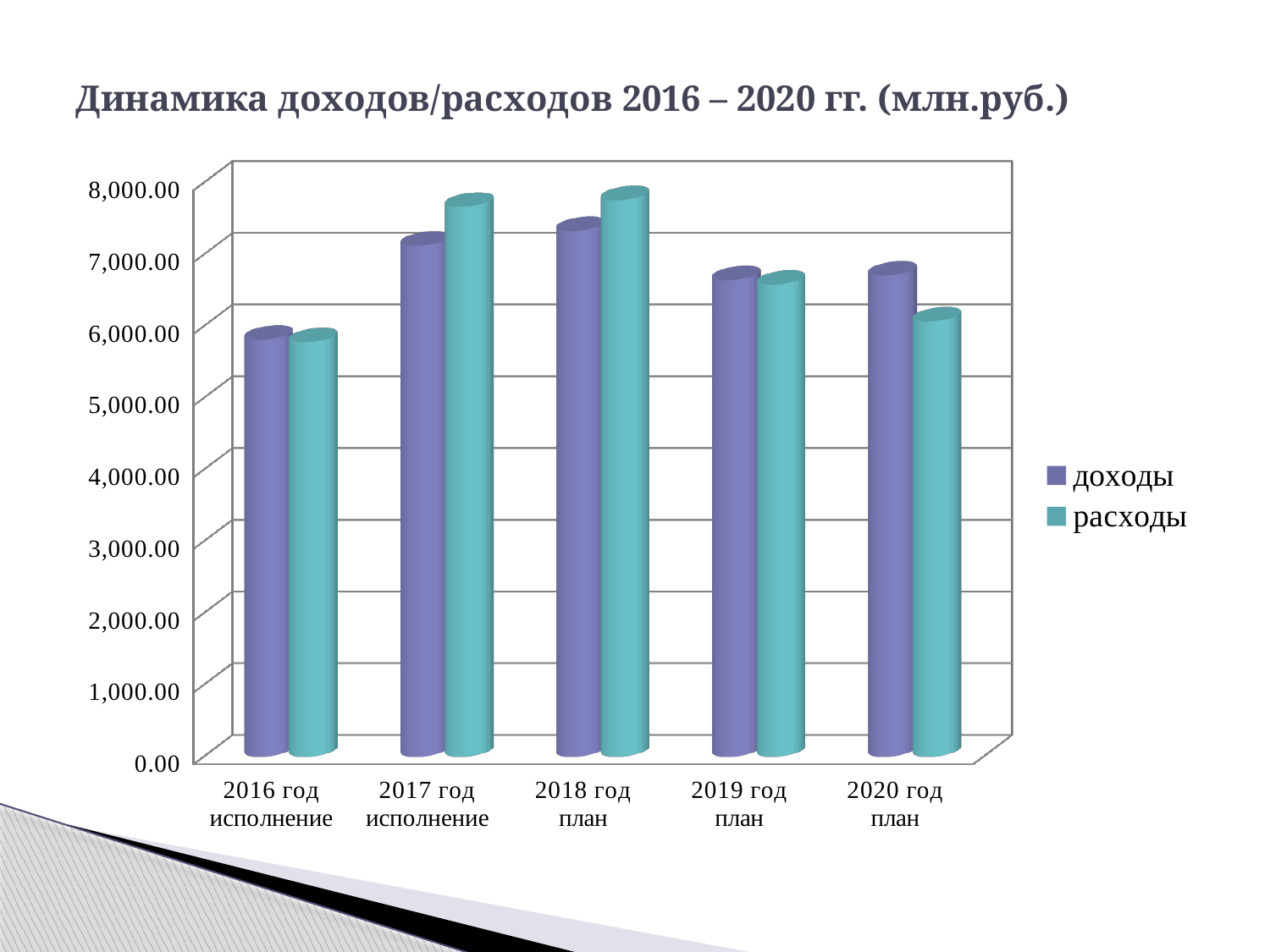
Is the value for расходы in 2017 год исполнение greater or less than 7,000.00? greater What is the title of the chart? Динамика доходов/расходов 2016 – 2020 гг. (млн.руб.) What kind of chart is shown on the slide? bar chart Which series is shown in teal bars? расходы How many year categories are shown on the x axis? 5 How many series does the legend list? 2 Which year has the lowest value for доходы? 2016 год исполнение Which year has the lowest value for расходы? 2016 год исполнение In 2017 год исполнение, which is larger: доходы or расходы? расходы In 2020 год план, which is larger: доходы or расходы? доходы Is the value for расходы in 2020 год план greater or less than 7,000.00? less